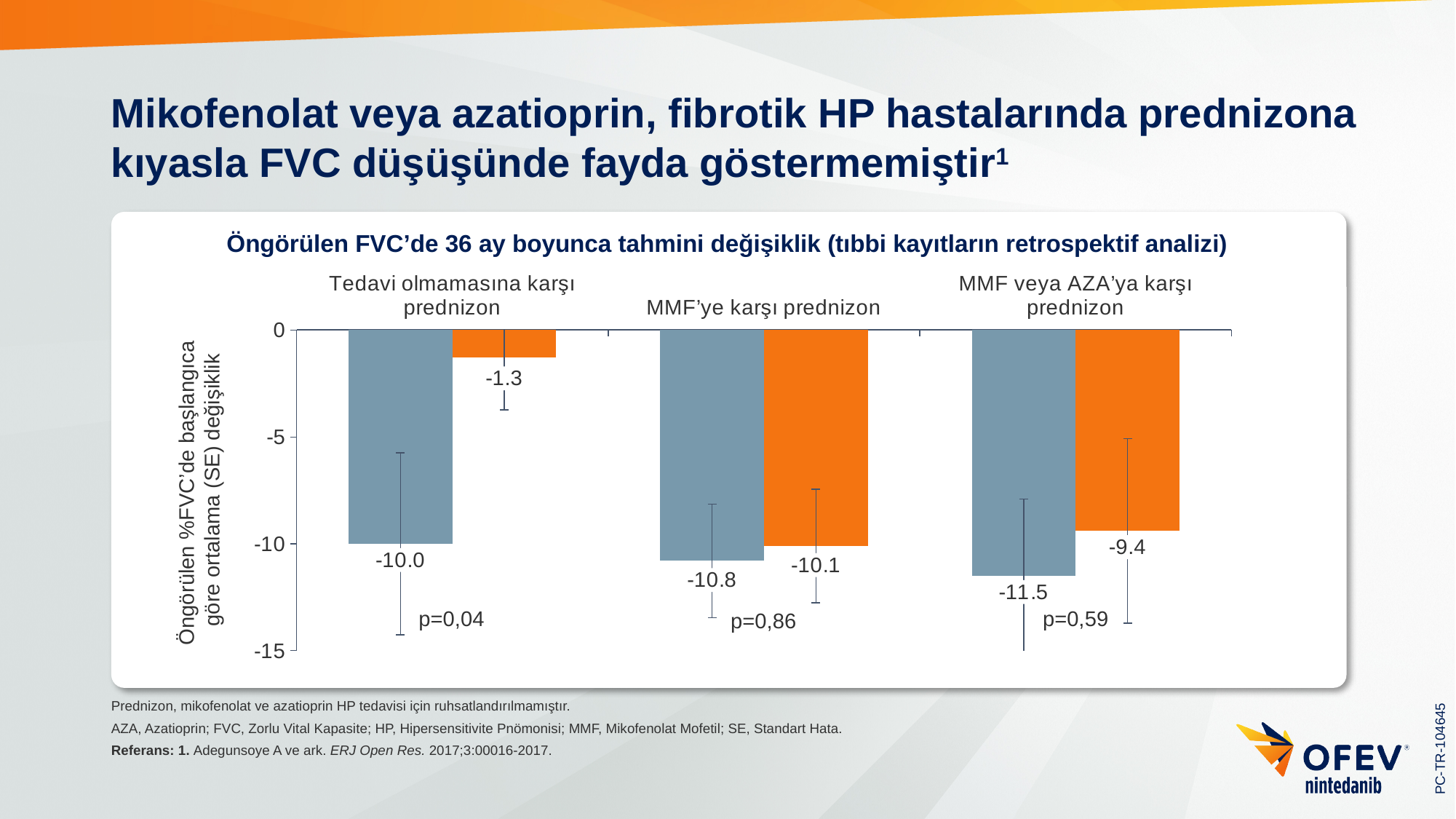
How many comparison groups are shown along the x axis of the chart? 3 In the 'MMF veya AZA'ya karşı prednizon' group, what is the value of the orange bar? -9.4 Which bar in the chart has the lowest (most negative) value? the grey-blue bar in the 'MMF veya AZA'ya karşı prednizon' group (-11.5) In the 'MMF veya AZA'ya karşı prednizon' group, which bar has the larger decline, the grey-blue bar or the orange bar? the grey-blue bar Which bar in the chart has the highest (least negative) value? the orange bar in the 'Tedavi olmamasına karşı prednizon' group (-1.3) What is the title of the chart? Öngörülen FVC'de 36 ay boyunca tahmini değişiklik (tıbbi kayıtların retrospektif analizi) What is the difference between the grey-blue bar (-10.0) and the orange bar (-1.3) in the 'Tedavi olmamasına karşı prednizon' group? 8.7 In the 'Tedavi olmamasına karşı prednizon' group, what is the value of the grey-blue bar? -10.0 What p-value is shown for the 'MMF'ye karşı prednizon' comparison? p=0,86 In the 'Tedavi olmamasına karşı prednizon' group, what is the value of the orange bar? -1.3 What type of chart is shown on the slide? bar chart In the 'MMF'ye karşı prednizon' group, what is the value of the grey-blue bar? -10.8